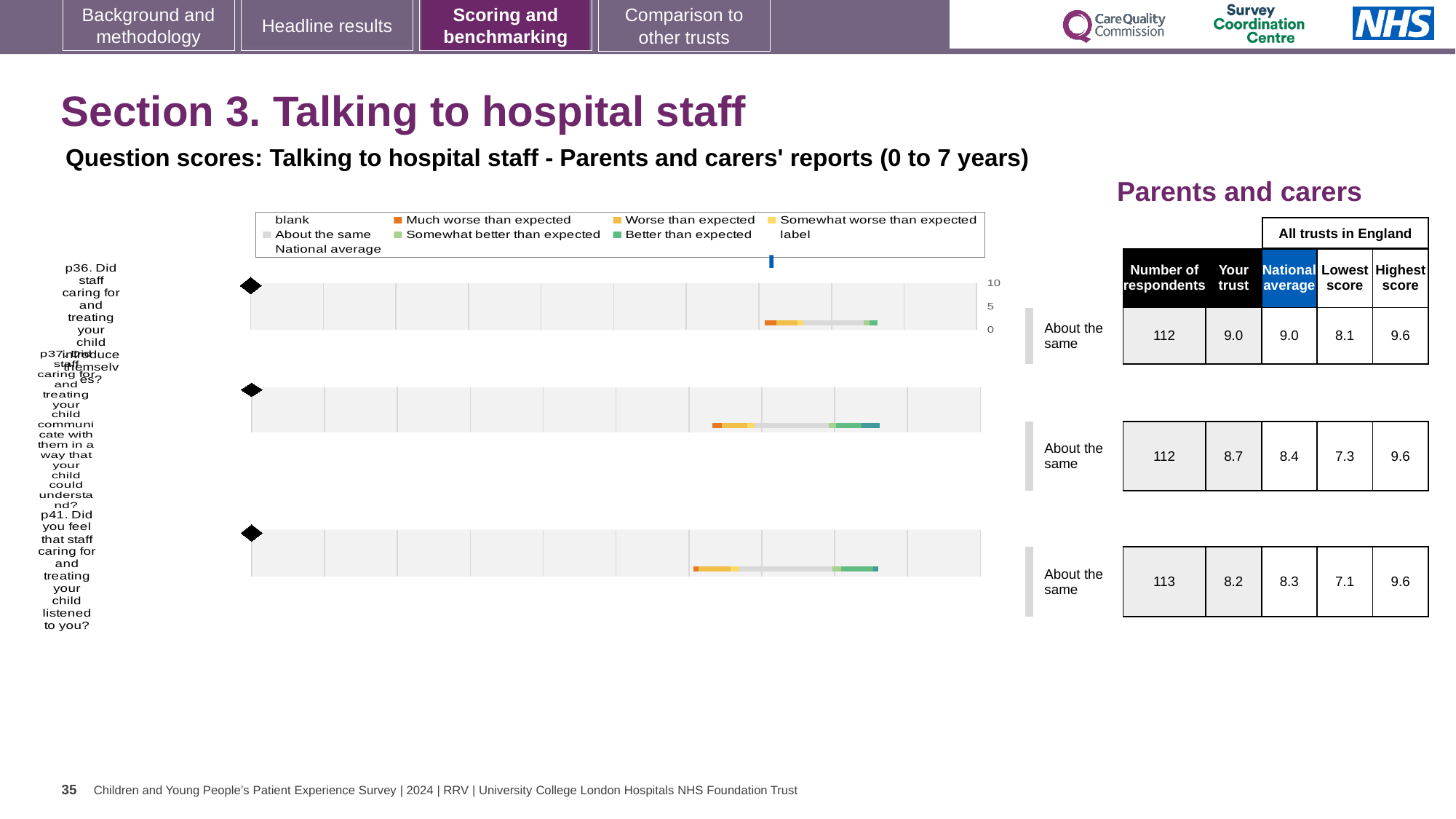
In the table beside the chart, what is the 'Your trust' score for p37 (Did staff communicate with them in a way that your child could understand)? 8.7 Which legend entry is shown in orange? Much worse than expected In the table beside the chart, what is the Lowest score for p37? 7.3 Which question has the higher 'Your trust' score in the table: p36 or p41? p36 What is the difference between the 'Your trust' score and the National average for p37 in the table? 0.3 What is the highest value shown on the chart's numeric axis? 10 What kind of chart is shown on the slide? bar chart In the table beside the chart, what is the National average for p41? 8.3 In the table beside the chart, what is the 'Your trust' score for p41 (Did you feel that staff caring for and treating your child listened to you)? 8.2 In the table beside the chart, how many respondents answered p41? 113 How many questions (categories) are plotted in the chart? 3 In the table beside the chart, what is the 'Your trust' score for p36 (Did staff caring for and treating your child introduce themselves)? 9.0